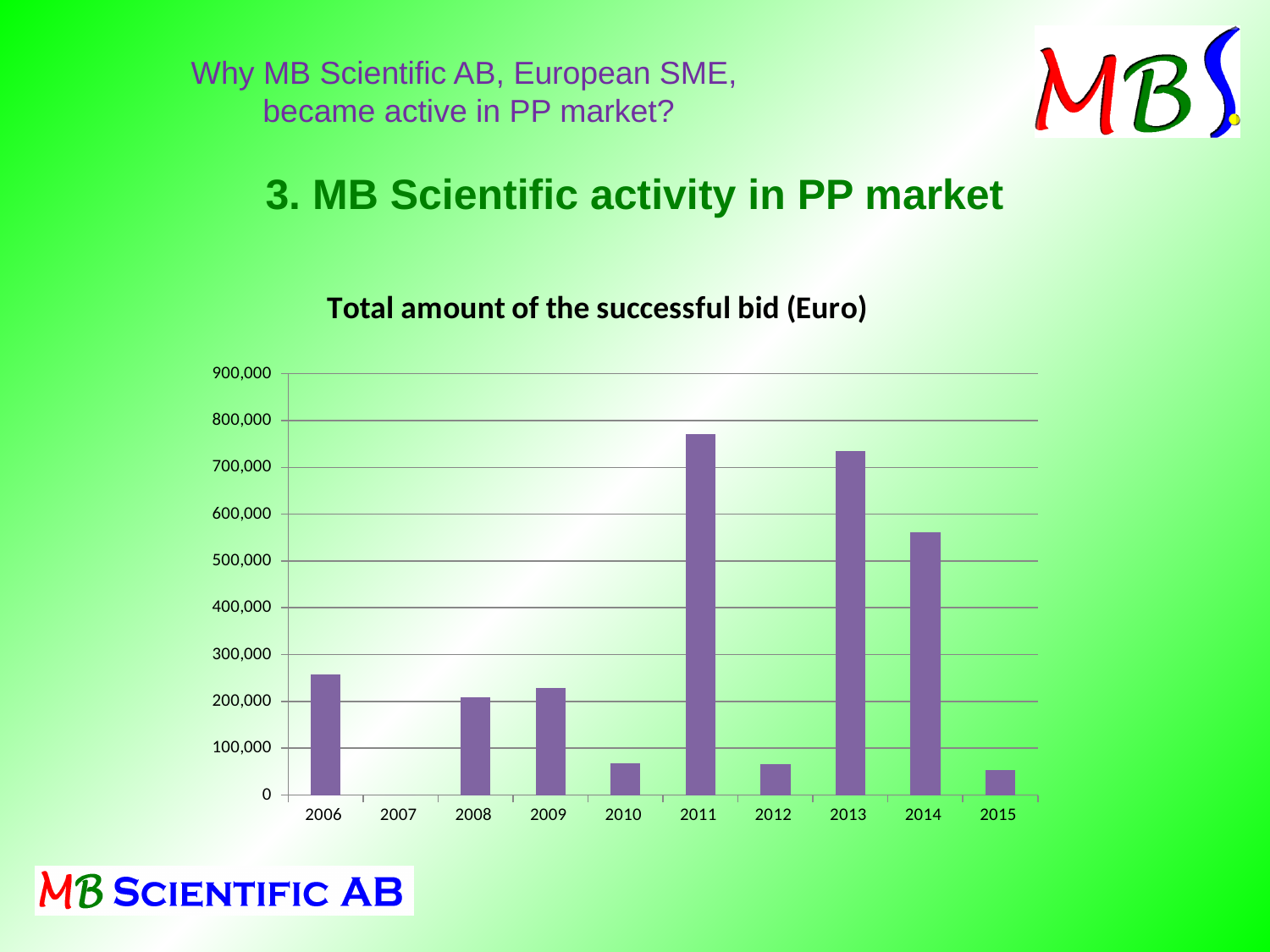
How many years are shown on the x axis of the chart? 10 Is the value for 2013 greater or less than 700,000? greater What kind of chart is shown on the slide? bar chart What is the title of the chart? Total amount of the successful bid (Euro) Is the value for 2014 greater or less than 600,000? less Is the value for 2015 greater or less than 100,000? less Which year has the highest total amount of successful bids? 2011 Which year has the larger value, 2006 or 2010? 2006 Which year has the larger value, 2013 or 2014? 2013 Which year shows no bar at all in the chart? 2007